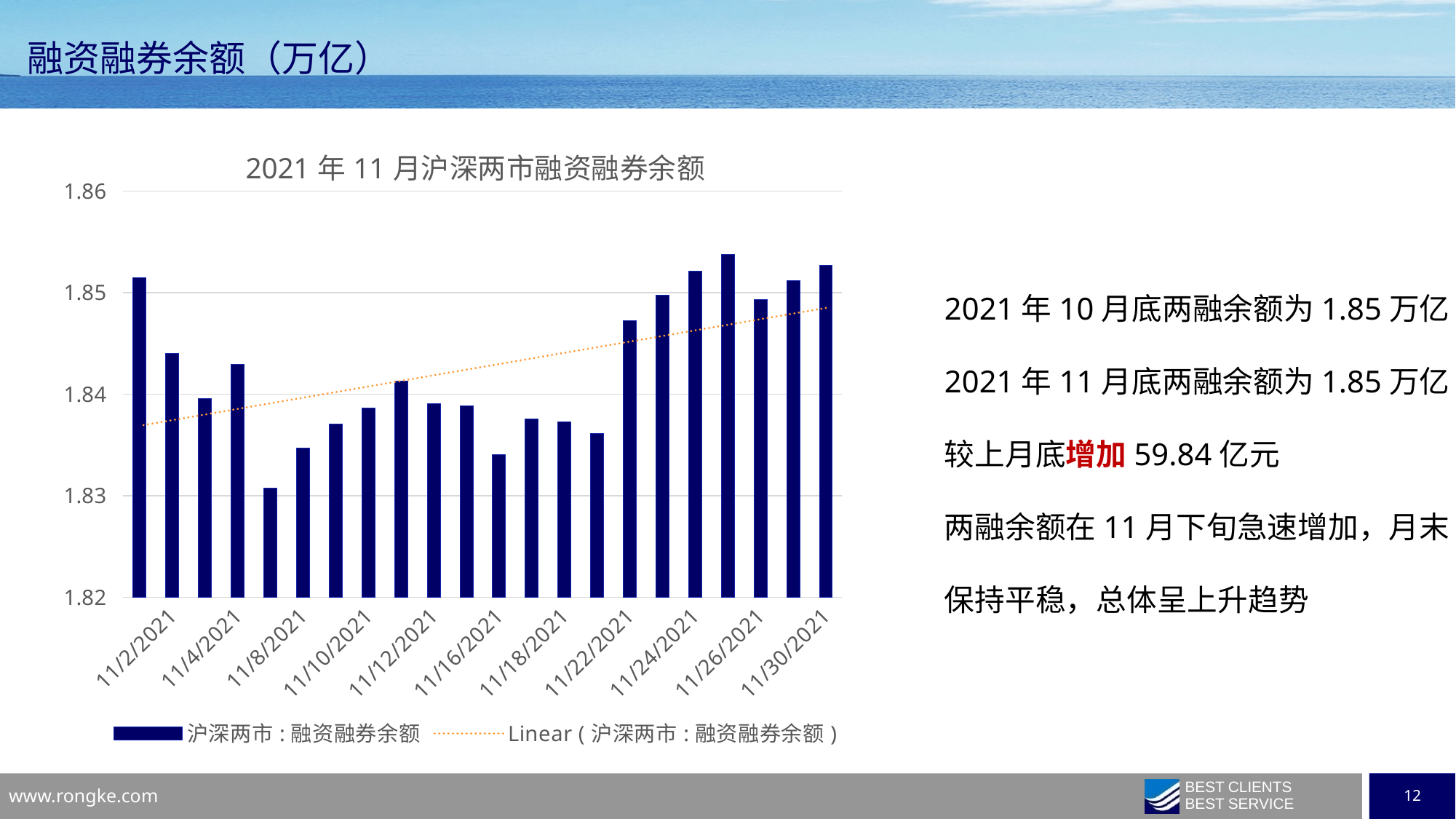
Is the value for 11/22/2021 greater or less than 1.84? greater Which is larger, the value for 11/30/2021 or the value for 11/8/2021? 11/30/2021 How many entries does the chart legend list? 2 Is the value for 11/30/2021 greater or less than 1.85? greater What is the title of the chart? 2021 年 11 月沪深两市融资融券余额 Does the dotted linear trendline rise or fall from left to right across the chart? Rises How many bars are plotted in the chart? 22 Is the value for 11/8/2021 greater or less than 1.84? less What type of chart is shown on the slide? Bar chart Which is larger, the value for 11/22/2021 or the value for 11/16/2021? 11/22/2021